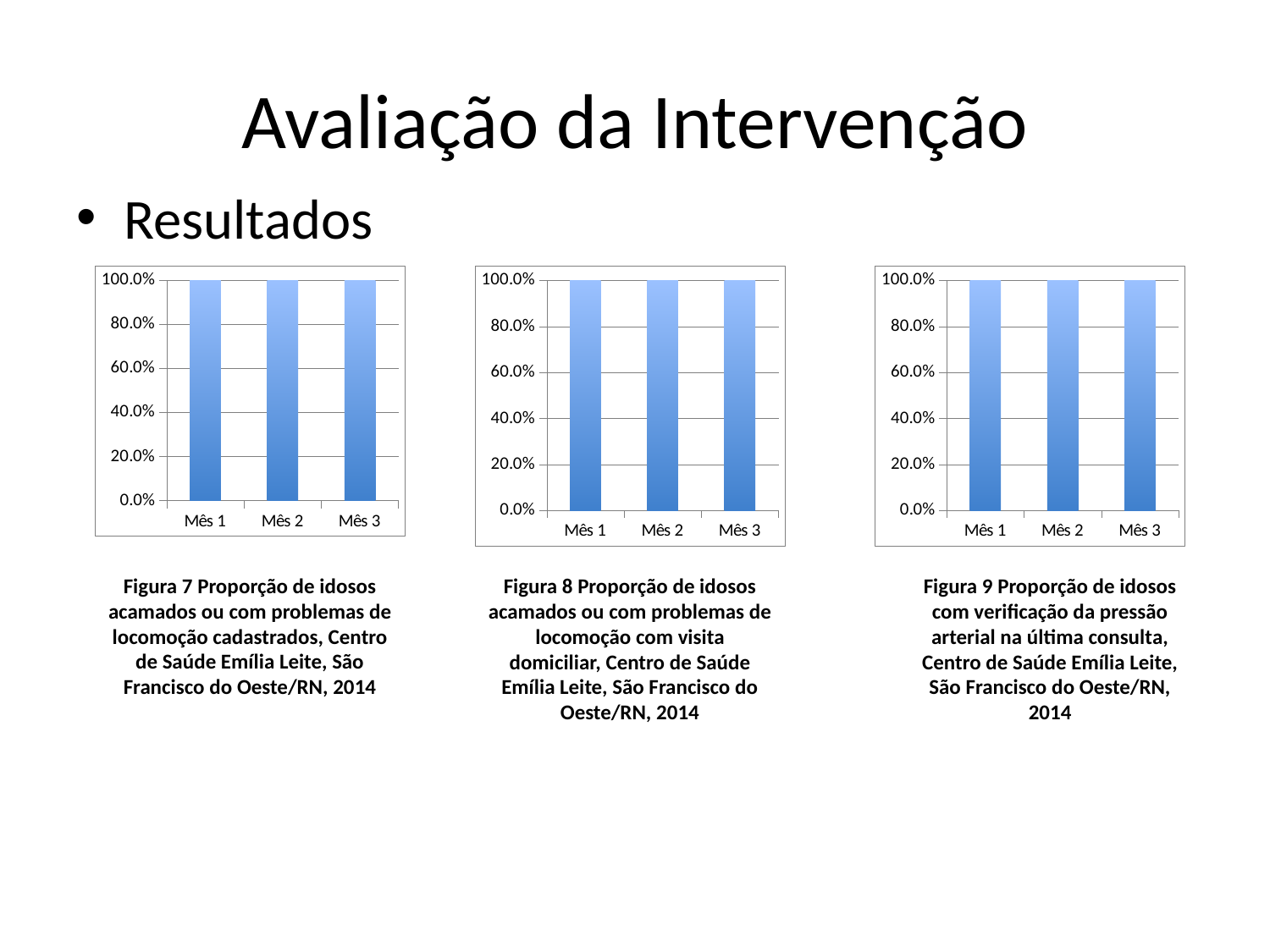
What is the label of the first category on the x axis of the right chart (Figura 9)? Mês 1 In the right chart (Figura 9), is the value for Mês 3 greater or less than 60.0%? greater In the left chart (Figura 7), what is the difference between the values for Mês 1 and Mês 3? 0.0% In the middle chart (Figura 8), what is the value for Mês 3? 100.0% How many categories are shown on the x axis of the left chart (Figura 7)? 3 In the middle chart (Figura 8), do the values rise, fall, or stay the same from Mês 1 to Mês 3? stay the same In the right chart (Figura 9), what is the value for Mês 2? 100.0% How many bars are plotted in the right chart (Figura 9)? 3 In the left chart (Figura 7), is the value for Mês 2 greater or less than 80.0%? greater In the left chart (Figura 7), what is the value for Mês 1? 100.0% What kind of chart is the middle chart (Figura 8)? bar chart How many bar charts are shown on the slide? 3